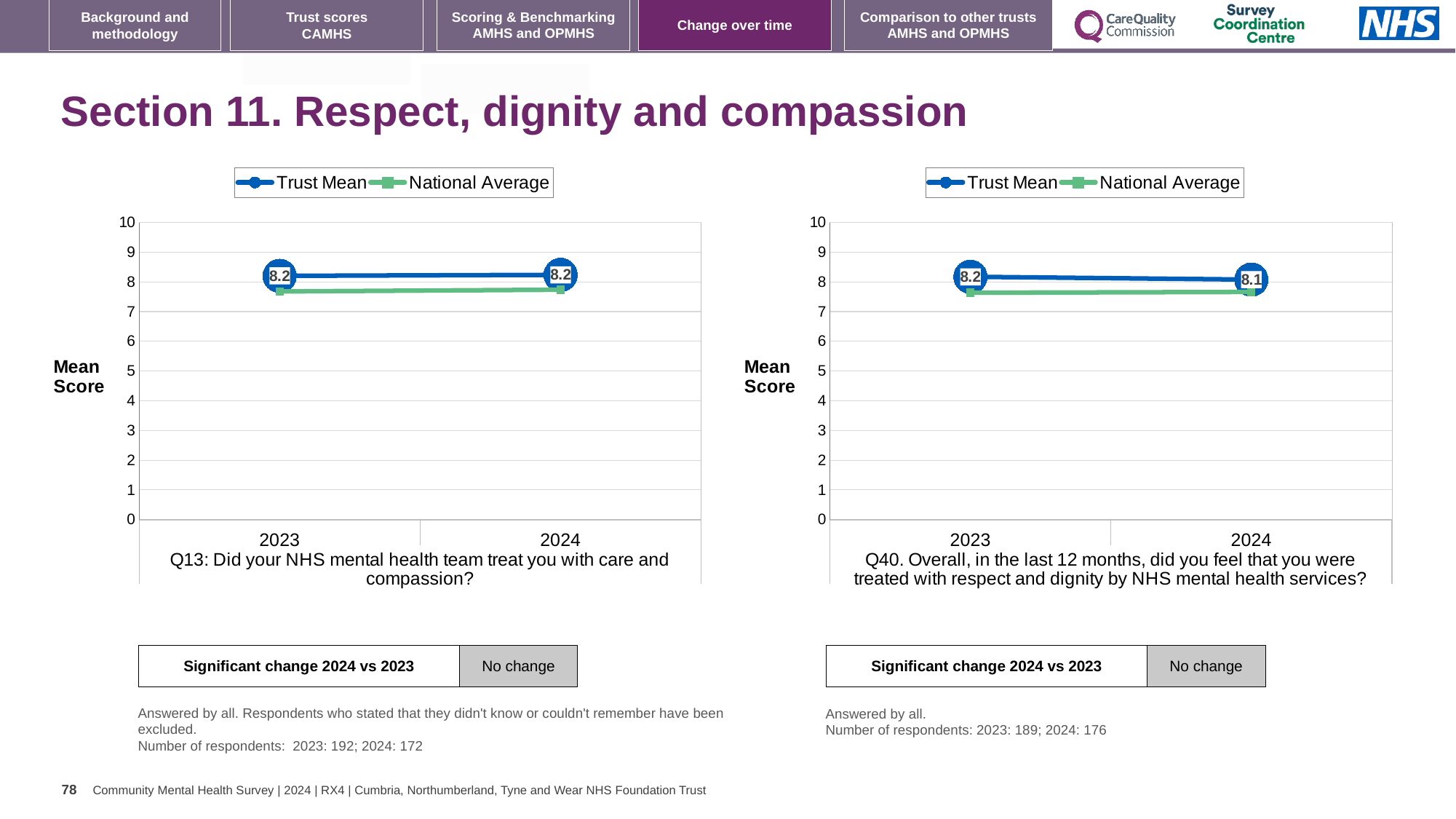
In the right chart (Q40), what is the Trust Mean score for 2023? 8.2 In the left chart (Q13), what is the Trust Mean score for 2023? 8.2 In the left chart (Q13), what is the Trust Mean score for 2024? 8.2 What kind of chart is the left chart (Q13)? line chart In the right chart (Q40), what is the difference between the Trust Mean in 2023 and in 2024? 0.1 In the right chart (Q40), what is the Trust Mean score for 2024? 8.1 How many years are plotted on the x axis of the right chart (Q40)? 2 In the left chart (Q13), is the National Average value for 2024 greater or less than 8? less In the right chart (Q40), does the Trust Mean rise or fall from 2023 to 2024? fall In the left chart (Q13), which series has the higher value in 2023, Trust Mean or National Average? Trust Mean How many series does the legend of the left chart (Q13) list? 2 In the right chart (Q40), is the National Average value for 2023 greater or less than 7? greater